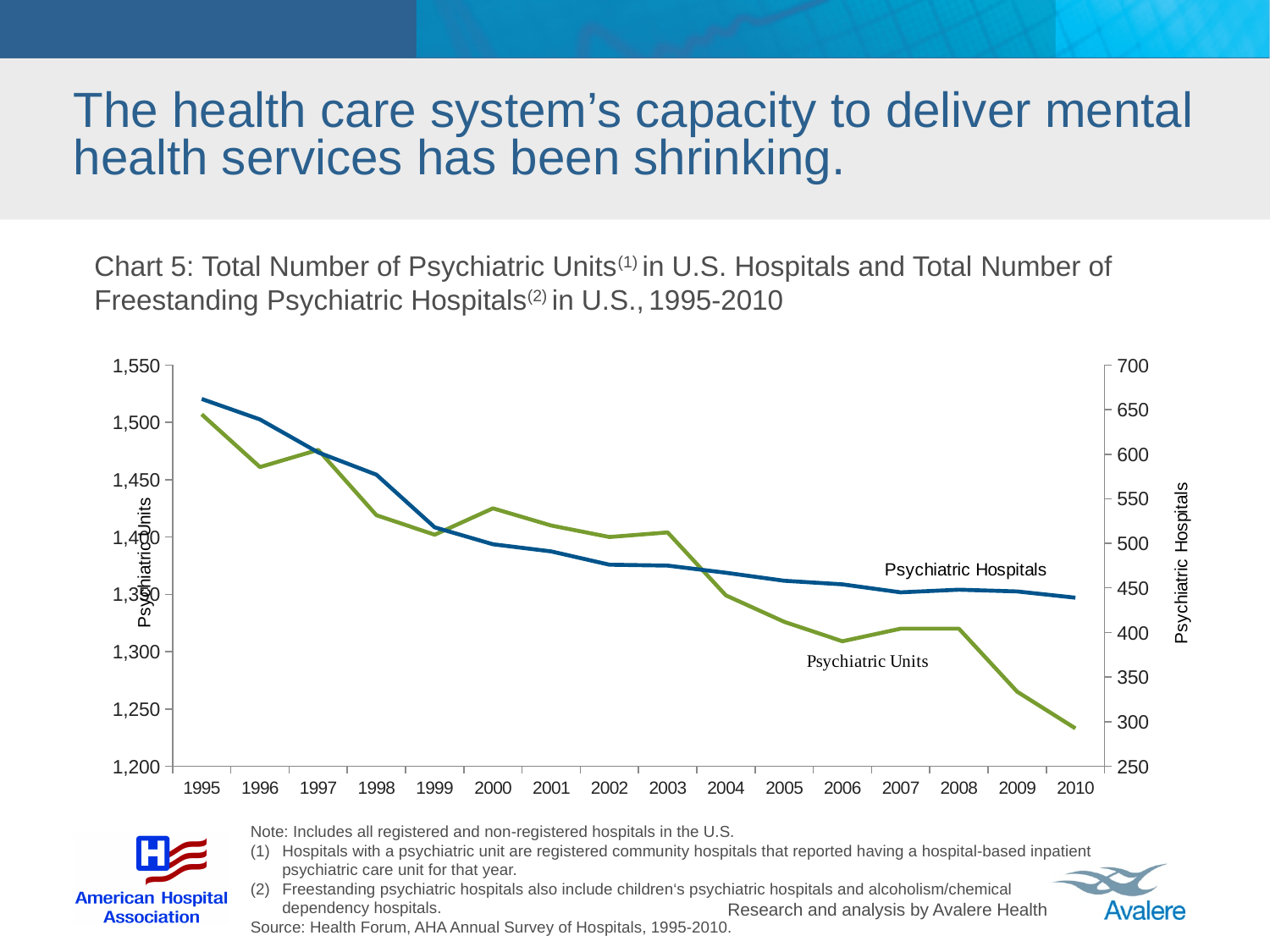
How many years are plotted along the x axis of the chart? 16 What is the title of the right-hand vertical axis? Psychiatric Hospitals What kind of chart is shown on the slide? line chart In which year is the Psychiatric Units series at its highest? 1995 Is the value for Psychiatric Units in 2006 greater or less than 1,350? less How many data series are plotted in the chart? 2 In which year is the Psychiatric Hospitals series at its lowest? 2010 In which year is the Psychiatric Units series at its lowest? 2010 Does the Psychiatric Hospitals series rise or fall from 1995 to 2010? fall Is the value for Psychiatric Hospitals in 1995 greater or less than 650? greater Does the Psychiatric Units series rise or fall from 1995 to 2010? fall Is the value for Psychiatric Units in 2010 greater or less than 1,250? less